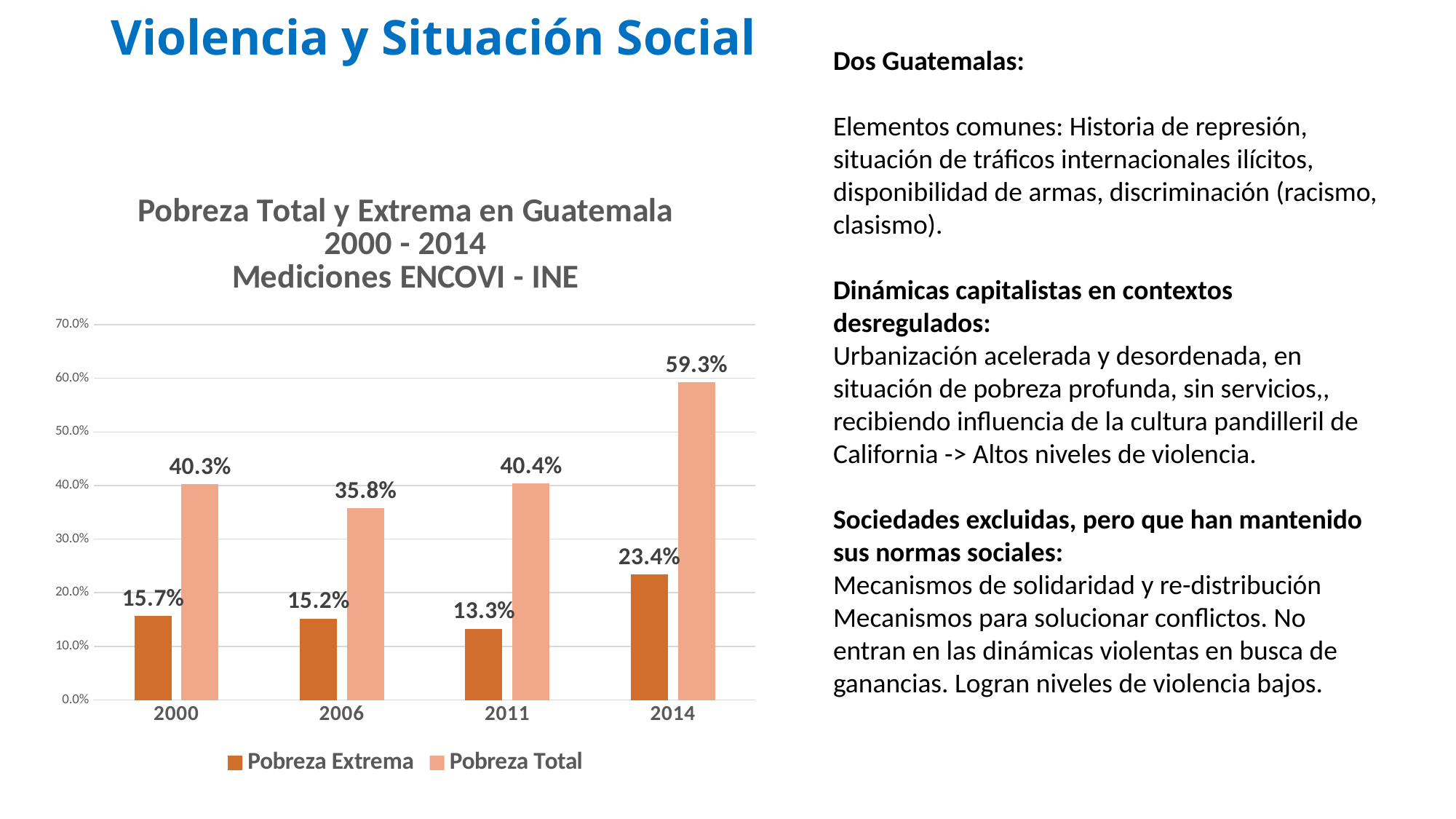
Which year has the lowest Pobreza Extrema value? 2011 Which year has the highest Pobreza Total value? 2014 Which is larger, Pobreza Extrema in 2000 or Pobreza Extrema in 2014? Pobreza Extrema in 2014 How many series does the chart legend list? 2 What is the Pobreza Total value for 2014? 59.3% How many years are shown on the x axis of the chart? 4 What is the Pobreza Total value for 2006? 35.8% What is the difference between Pobreza Total and Pobreza Extrema in 2014? 35.9% What is the Pobreza Extrema value for 2011? 13.3% What kind of chart is shown on the slide? bar chart What are the two series named in the chart legend? Pobreza Extrema and Pobreza Total Is the Pobreza Total value for 2011 greater or less than 50.0%? less